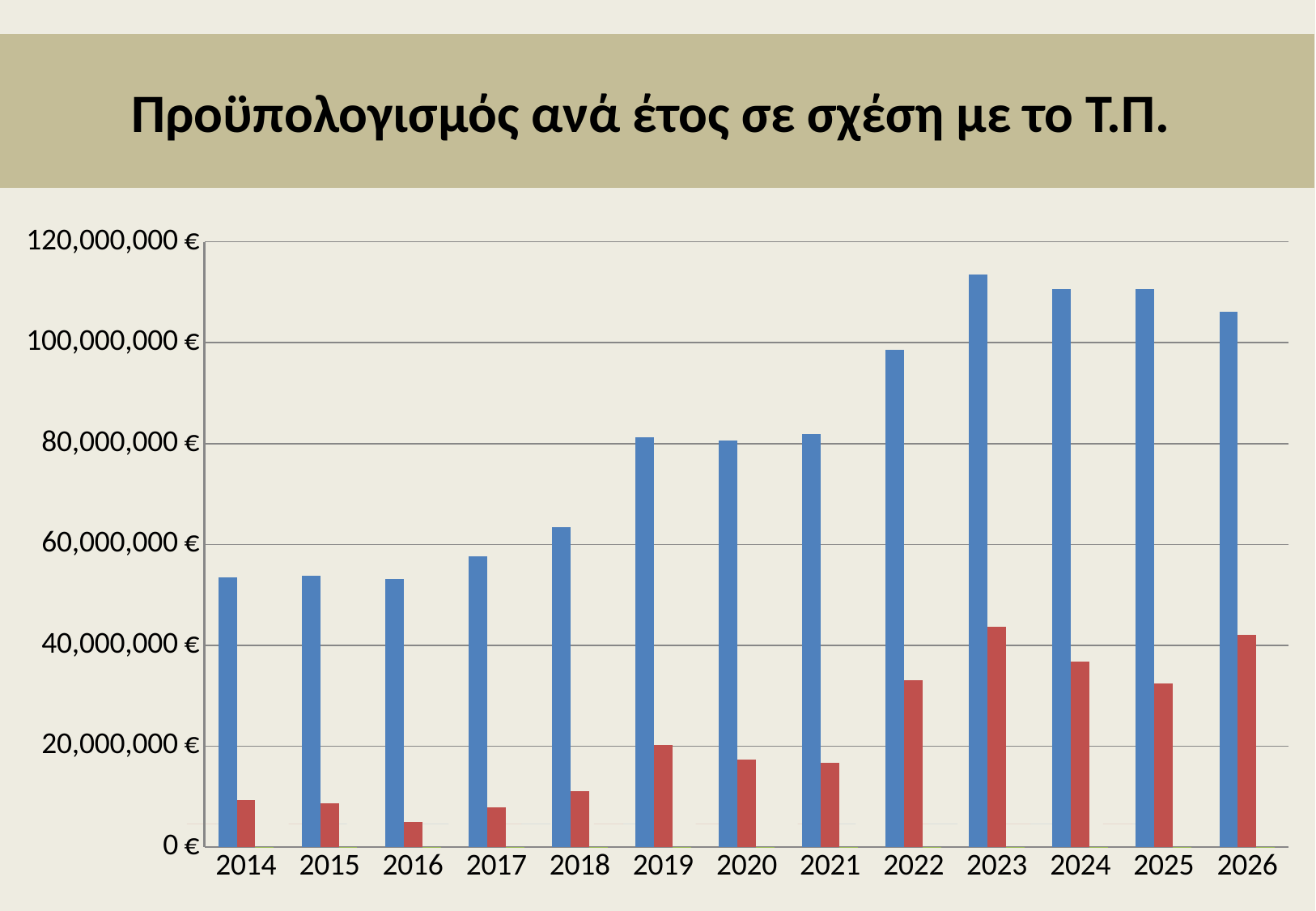
Do the blue bars generally rise or fall from 2014 to 2023? rise In which year is the red bar the shortest? 2016 Is the value of the red bar for 2022 greater or less than 20,000,000 €? greater Is the value of the red bar for 2016 greater or less than 20,000,000 €? less What kind of chart is shown on the slide? bar chart In which year is the blue bar the tallest? 2023 How many years are shown on the x axis of the chart? 13 Which is larger, the blue bar for 2022 or the blue bar for 2019? 2022 What is the title of the chart on the slide? Προϋπολογισμός ανά έτος σε σχέση με το Τ.Π. Is the value of the blue bar for 2023 greater or less than 100,000,000 €? greater In which year is the red bar the tallest? 2023